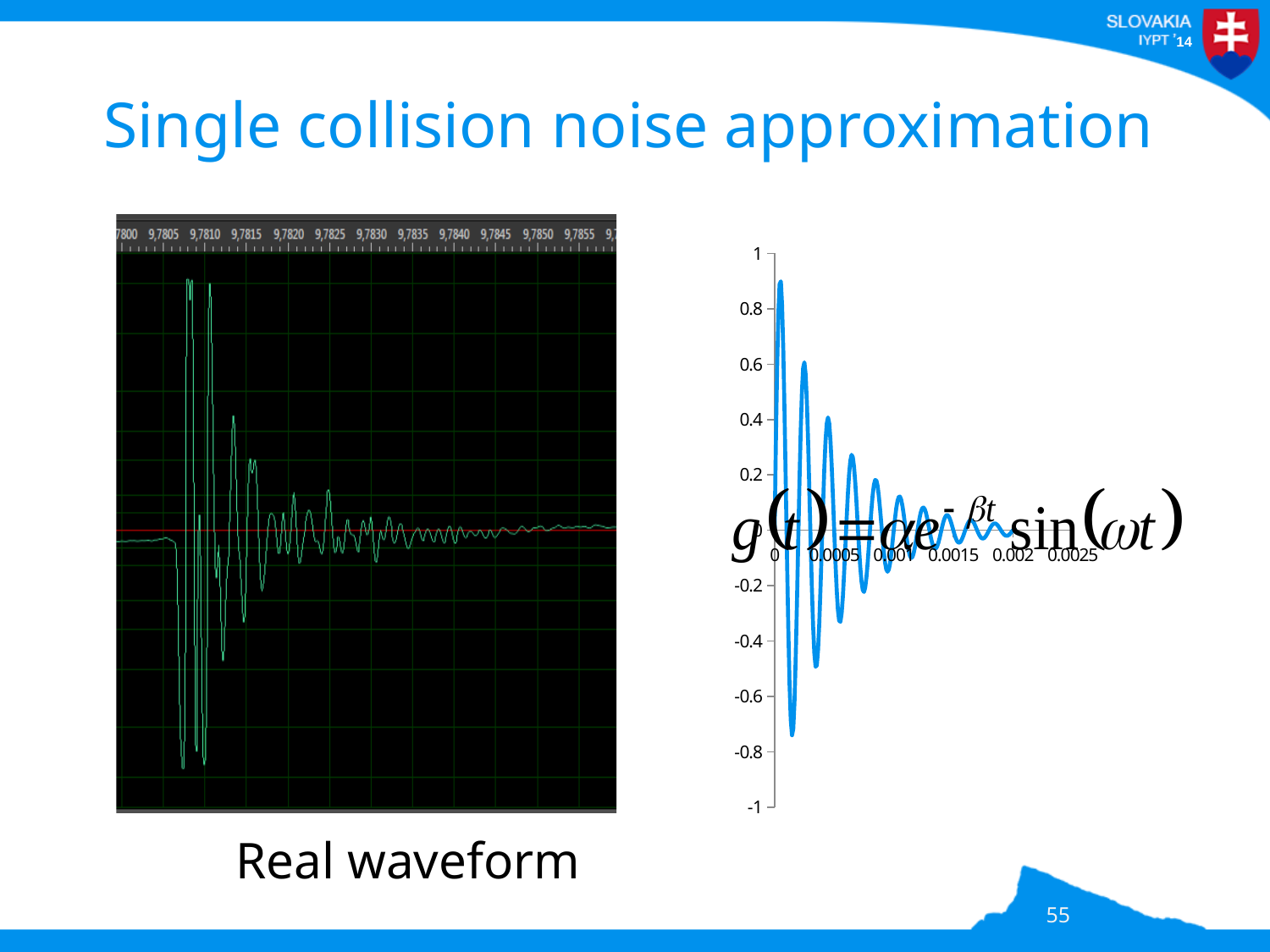
On the right chart, how many tick labels are shown on the horizontal axis? 6 On the right chart, is the value of the first trough of the curve greater or less than -0.6? less What kind of chart is the chart on the right of the slide? line chart On the right chart, what is the lowest value shown on the vertical axis? -1 On the right chart, what is the highest value shown on the vertical axis? 1 On the right chart, what is the largest tick label on the horizontal axis? 0.0025 On the right chart, does the amplitude of the oscillation increase or decrease as time increases along the x axis? decrease On the right chart, is the value of the first peak of the curve greater or less than 0.6? greater What caption is written under the chart on the left of the slide? Real waveform